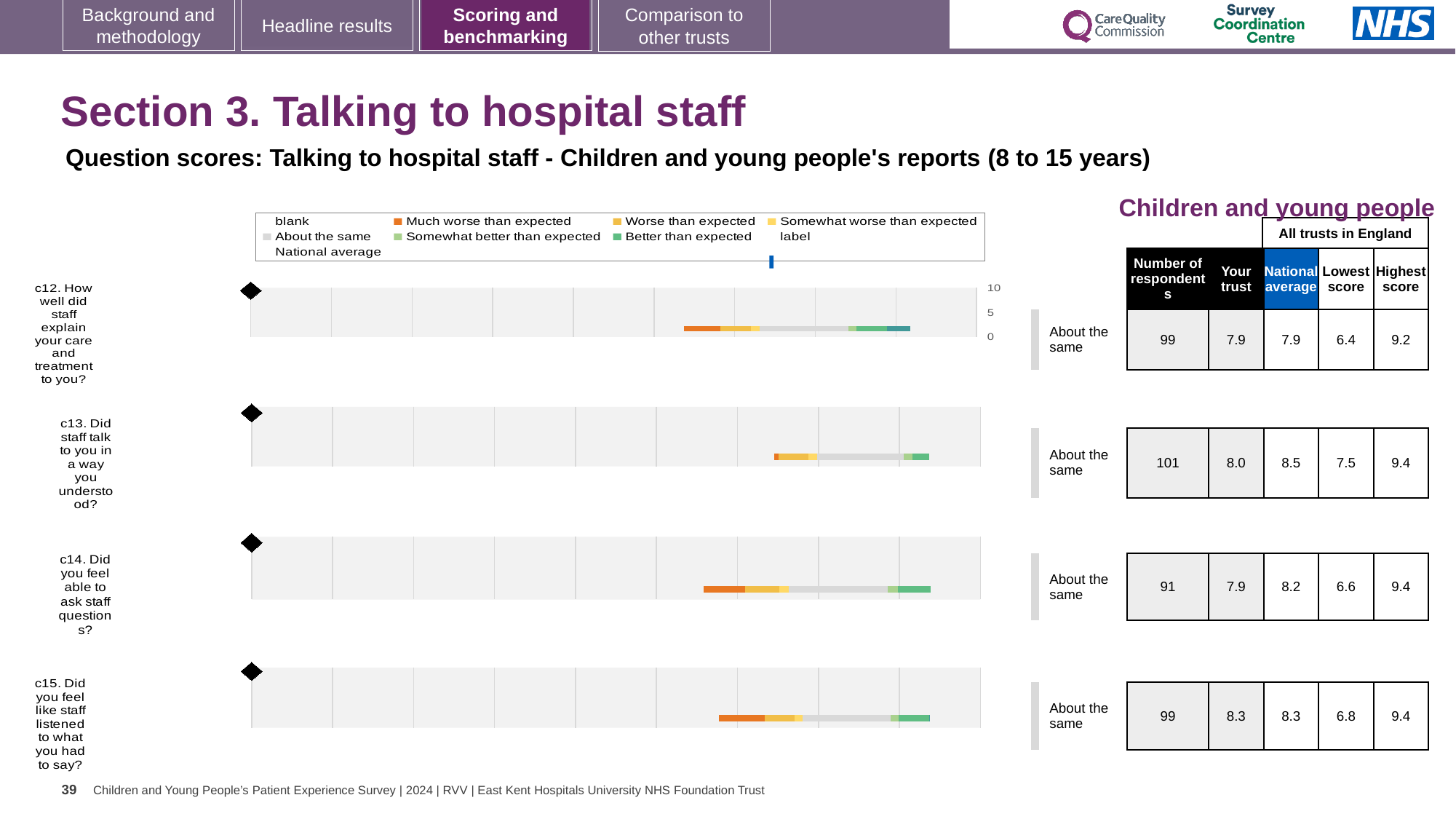
What benchmark category is shown for question c15? About the same For question c15, what is the lowest score among all trusts in England? 6.8 For question c14, how many respondents are there? 91 For question c14, which is larger: the 'Your trust' score or the national average? National average For question c13, what is the national average score? 8.5 For question c12, what is the 'Your trust' score? 7.9 Which question has the highest 'Your trust' score? c15 How many questions (charts) are shown on the slide? 4 For question c13, what is the difference between the national average and the 'Your trust' score? 0.5 Which question has the lowest 'Lowest score' value? c12 What kind of chart is used for question c12 on the slide? bar chart